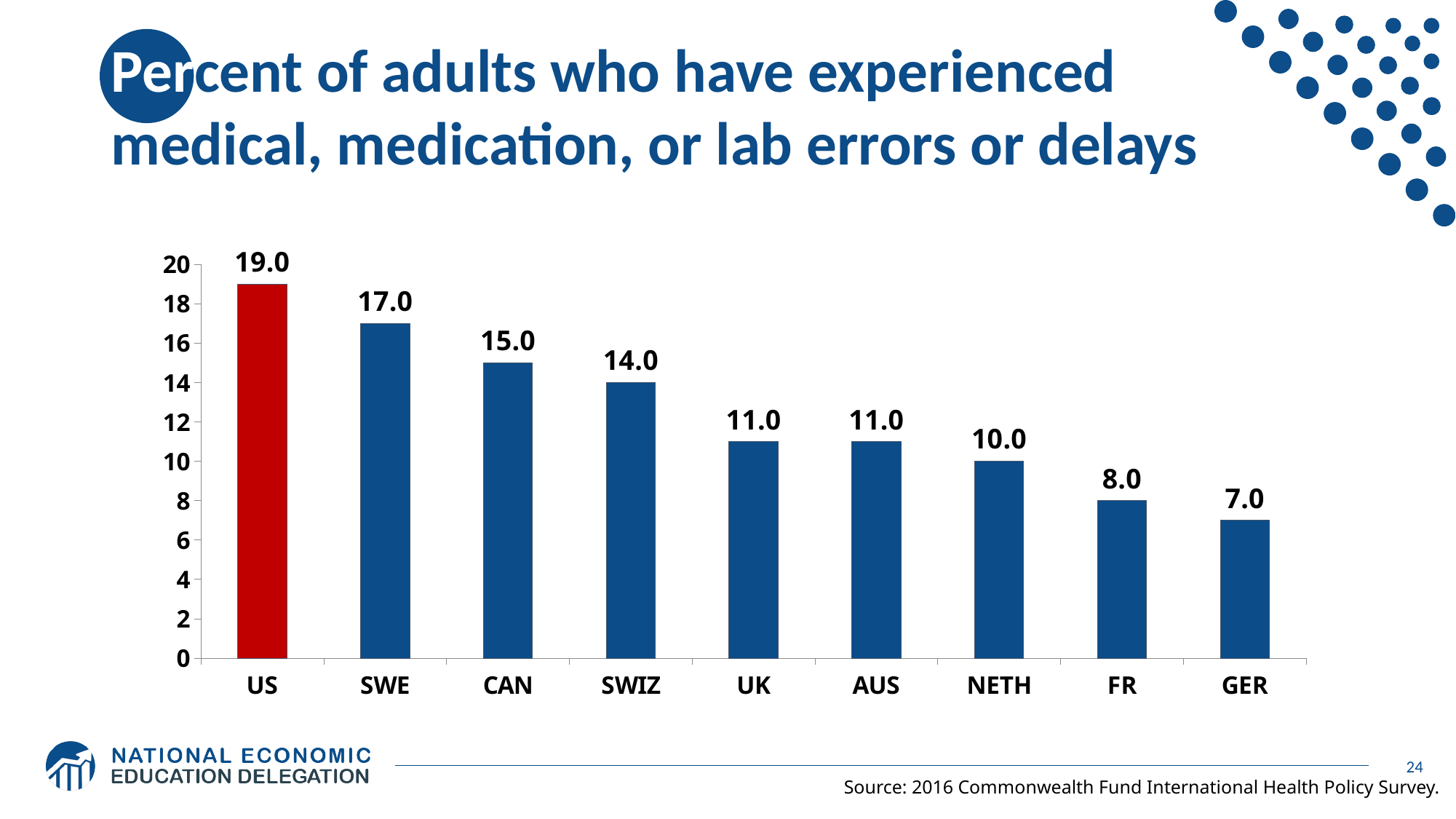
What is the difference between the values for the US and SWE? 2.0 Is the value for CAN greater or less than 10? greater What is the value for SWIZ? 14.0 What is the value for the US? 19.0 What is the difference between the values for CAN and GER? 8.0 Which country has the lowest value? GER What is the value for NETH? 10.0 What kind of chart is shown on the slide? bar chart Which country has the highest value? US How many countries are shown in the chart? 9 Which bar is coloured red rather than blue? US Which is larger, the value for FR or the value for NETH? NETH